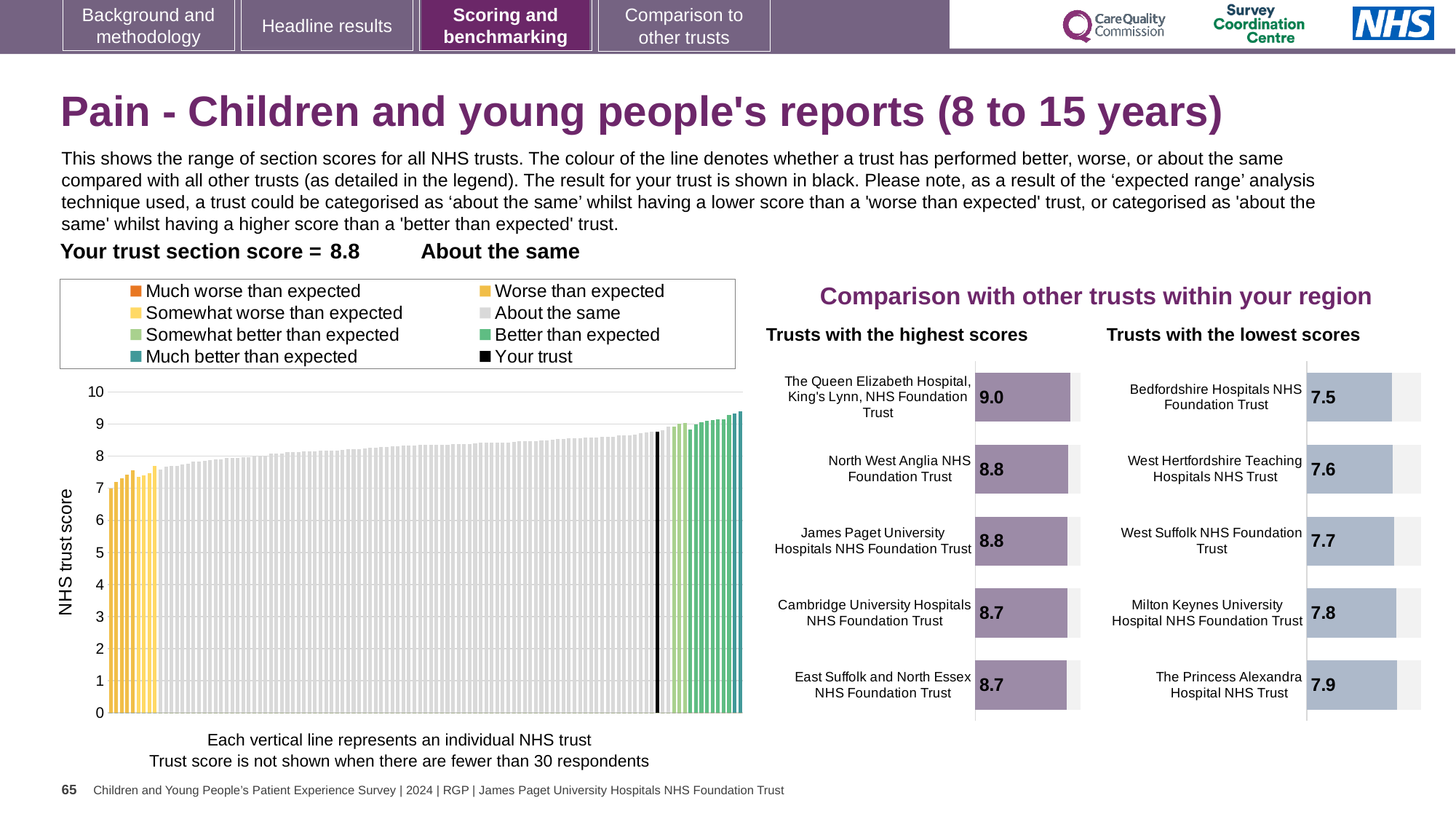
In the 'Trusts with the highest scores' chart, what is the difference between the scores of The Queen Elizabeth Hospital, King's Lynn and East Suffolk and North Essex NHS Foundation Trust? 0.3 In the 'Trusts with the lowest scores' chart, which trust has the lowest score? Bedfordshire Hospitals NHS Foundation Trust How many entries does the legend above the large chart on the left list? 8 In the 'Trusts with the highest scores' chart, which trust has the highest score? The Queen Elizabeth Hospital, King's Lynn, NHS Foundation Trust In the 'Trusts with the lowest scores' chart, which has the larger score: Milton Keynes University Hospital NHS Foundation Trust or West Hertfordshire Teaching Hospitals NHS Trust? Milton Keynes University Hospital NHS Foundation Trust In the large chart on the left, what is the label on the vertical axis? NHS trust score How many trusts are shown in the 'Trusts with the lowest scores' chart? 5 In the large chart on the left, is the value for the black 'Your trust' bar greater or less than 8? greater In the 'Trusts with the highest scores' chart, what is the score for The Queen Elizabeth Hospital, King's Lynn, NHS Foundation Trust? 9.0 What kind of chart is the large chart on the left of the slide? bar chart In the large chart on the left, is the value of the tallest bar greater or less than 9? greater In the 'Trusts with the lowest scores' chart, what is the score for West Suffolk NHS Foundation Trust? 7.7